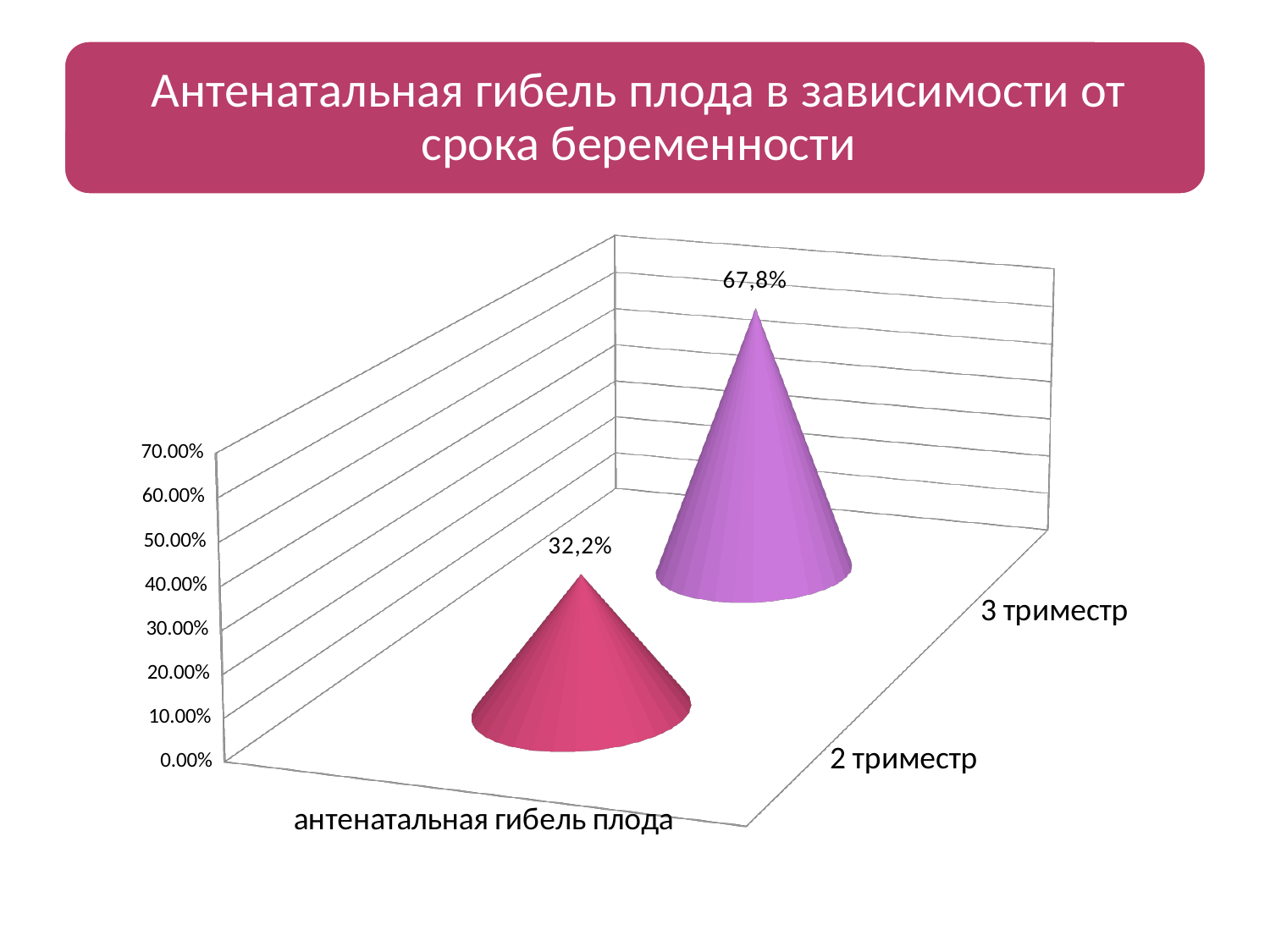
How many cones (data points) are plotted on the chart? 2 Which trimester has the lowest value? 2 триместр What is the label on the category axis of the chart? антенатальная гибель плода What kind of chart is shown on the slide? bar chart Which trimester has the highest value? 3 триместр What is the difference between the values for 3 триместр and 2 триместр? 35,6% What is the title of the slide? Антенатальная гибель плода в зависимости от срока беременности What is the value for 3 триместр? 67,8% Is the value for 2 триместр greater or less than 40.00%? less Which is larger, the value for 2 триместр or the value for 3 триместр? 3 триместр Is the value for 3 триместр greater or less than 60.00%? greater What is the value for 2 триместр? 32,2%